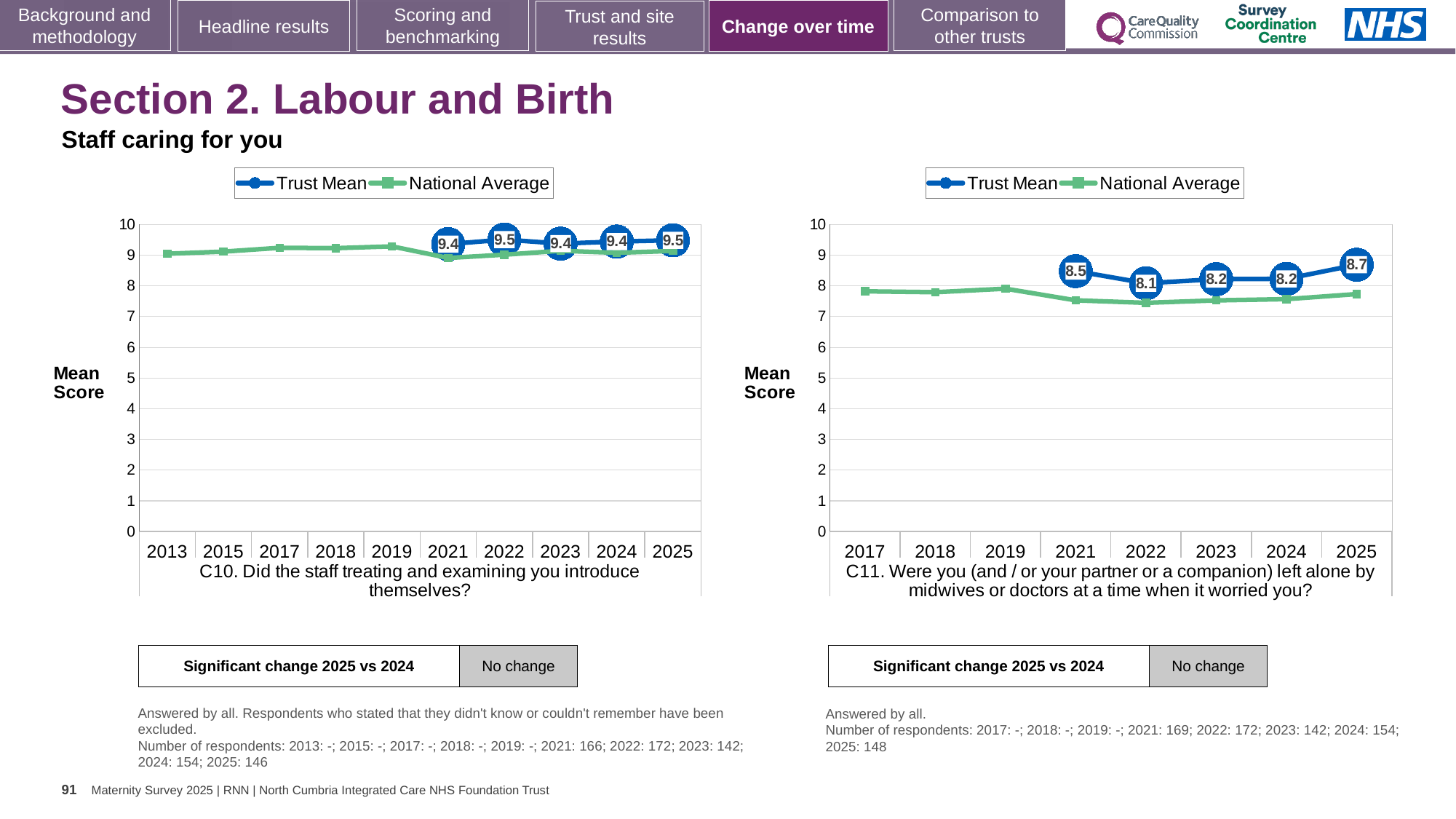
What kind of chart is the C10 chart on the left? Line chart In the C11 chart on the right, which year has the lowest Trust Mean? 2022 In the C11 chart on the right, what is the difference between the Trust Mean for 2025 and the Trust Mean for 2022? 0.6 In the C11 chart on the right, what is the Trust Mean for 2022? 8.1 How many years are shown on the x axis of the C10 chart on the left? 10 In the C11 chart on the right, is the Trust Mean for 2021 larger or smaller than the Trust Mean for 2024? larger In the C11 chart on the right, which year has the highest Trust Mean? 2025 In the C11 chart on the right, is the National Average for 2025 greater or less than 8? less How many series does the legend of the C11 chart on the right list? 2 In the C11 chart on the right, what is the Trust Mean for 2025? 8.7 In the C10 chart on the left, what is the Trust Mean for 2025? 9.5 In the C10 chart on the left, what is the Trust Mean for 2021? 9.4